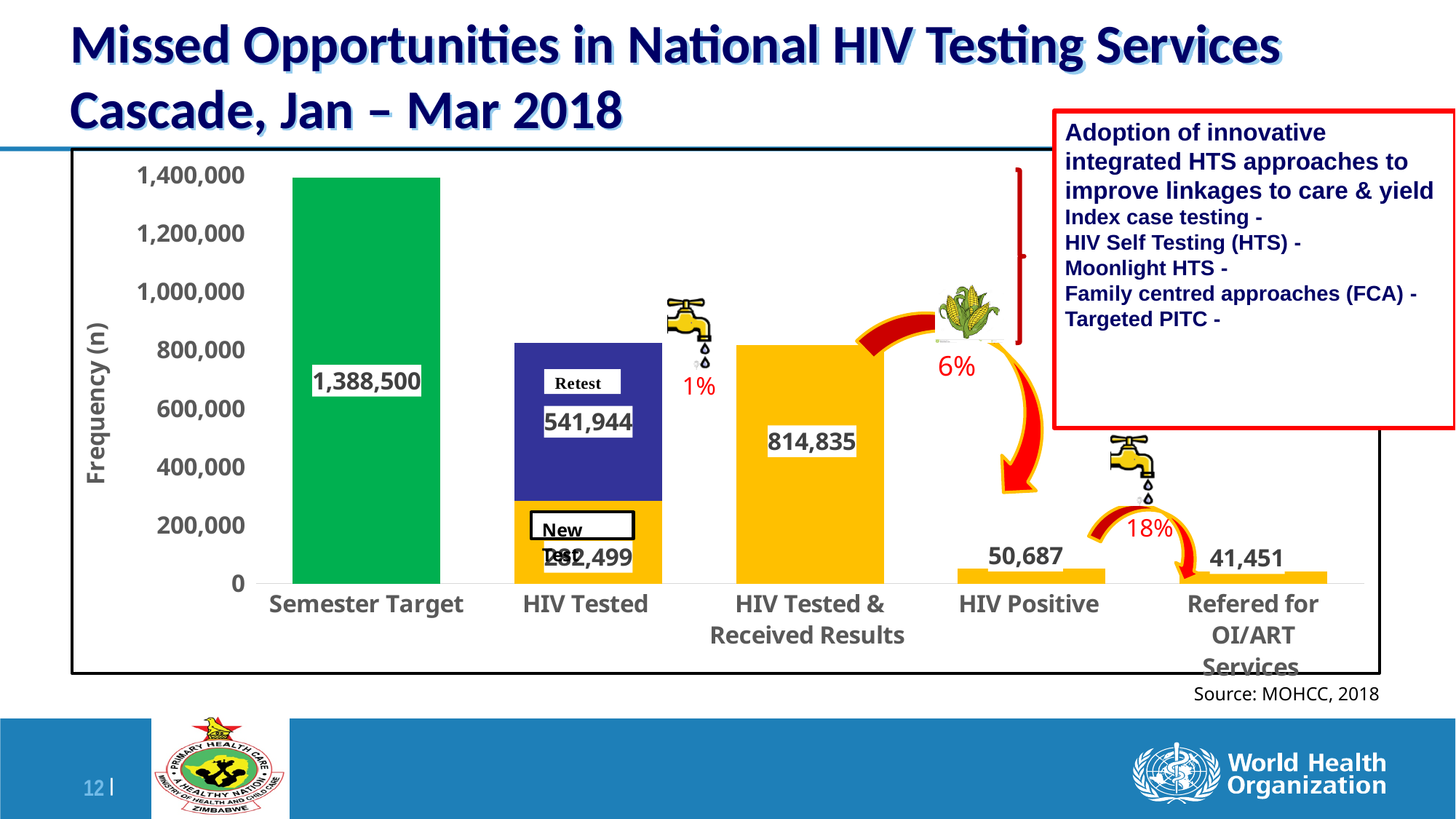
Which category has the lowest value? Refered for OI/ART Services What is the value for HIV Tested & Received Results? 814,835 What is the Retest value within the HIV Tested bar? 541,944 What is the difference between Semester Target and HIV Tested & Received Results? 573,665 What is the value for HIV Positive? 50,687 Which category has the highest value? Semester Target What is the label of the y axis? Frequency (n) What is the value for Semester Target? 1,388,500 What kind of chart is shown on the slide? bar chart How many categories are shown on the x axis? 5 What is the difference between HIV Positive and Refered for OI/ART Services? 9,236 What is the value for Refered for OI/ART Services? 41,451